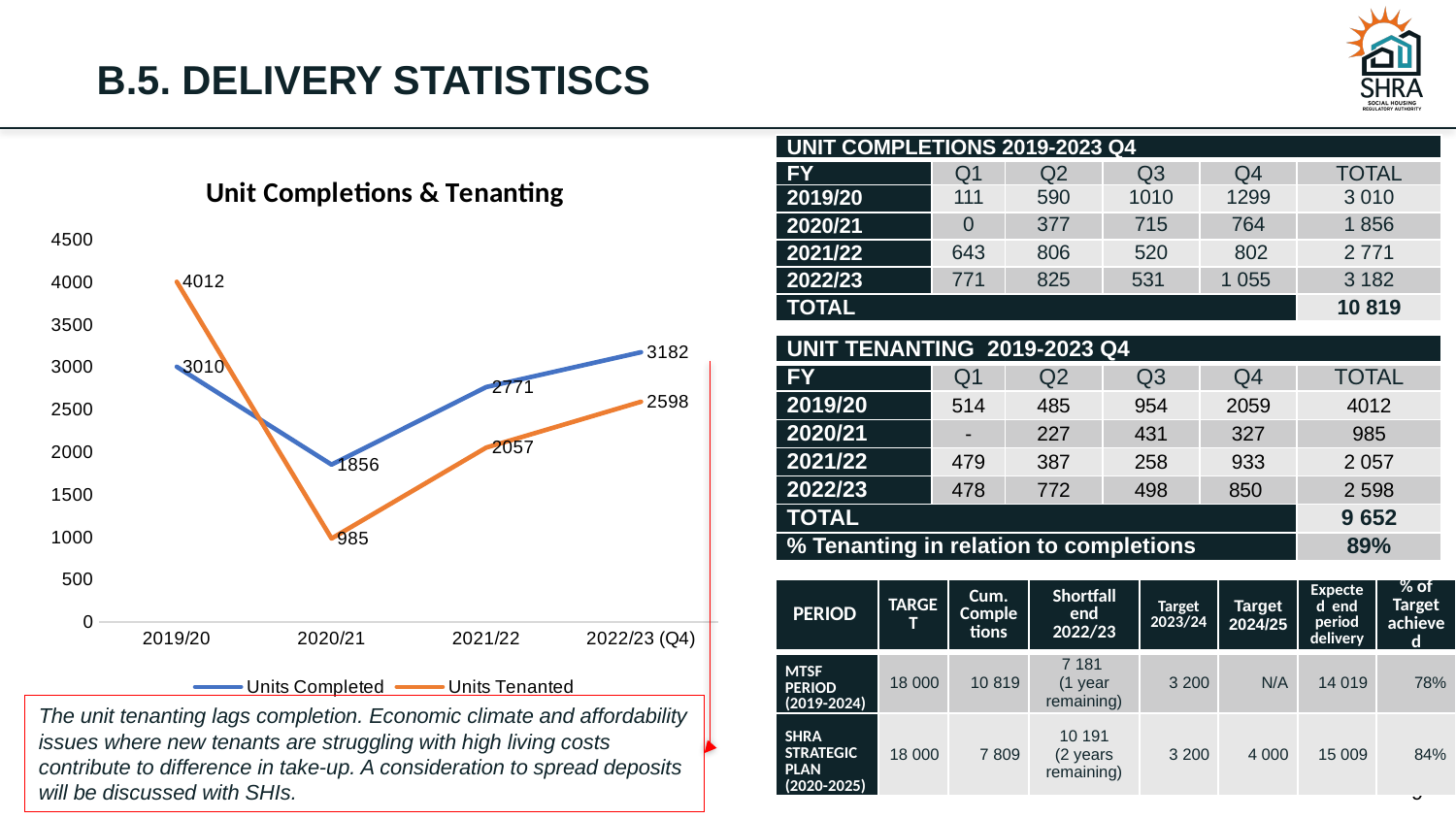
What is the value of Units Tenanted for 2022/23 (Q4)? 2598 Do the Units Completed values rise or fall from 2020/21 to 2022/23 (Q4)? rise What is the difference between Units Completed and Units Tenanted in 2021/22? 714 What is the value of Units Tenanted for 2019/20? 4012 Which category has the highest value for Units Completed? 2022/23 (Q4) In 2019/20, which is larger: Units Completed or Units Tenanted? Units Tenanted How many series does the chart legend list? 2 How many categories are shown on the x axis of the chart? 4 Which category has the lowest value for Units Tenanted? 2020/21 What is the value of Units Completed for 2020/21? 1856 What type of chart is shown on the slide? line chart What is the title of the chart? Unit Completions & Tenanting